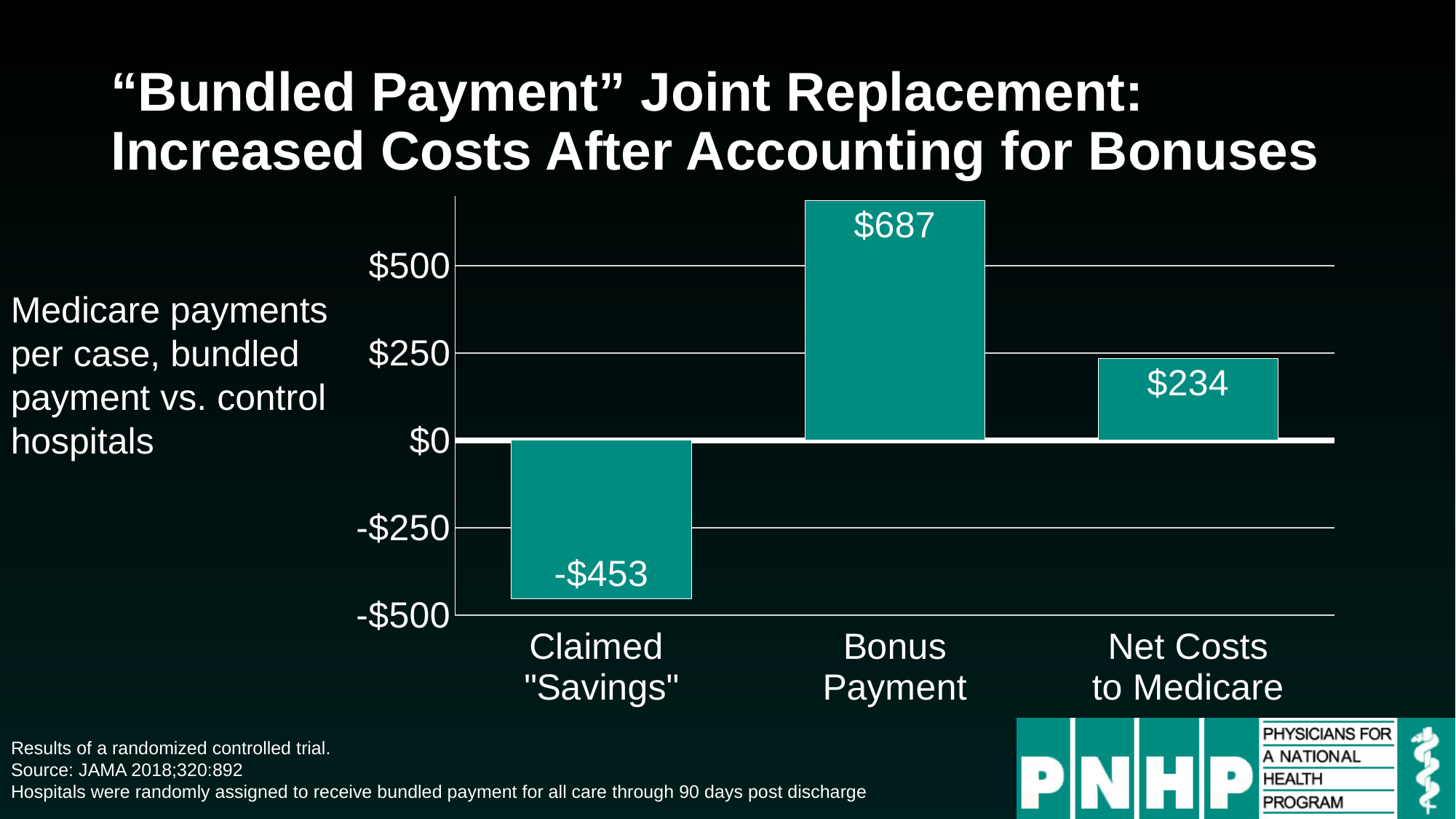
What is the value for Bonus Payment? $687 How many categories are shown on the chart? 3 Is the value for Net Costs to Medicare greater or less than $250? less Which category has the highest value? Bonus Payment Which is larger, the value for Bonus Payment or the value for Net Costs to Medicare? Bonus Payment Which category has a negative value? Claimed "Savings" What is the difference between the Bonus Payment value and the Net Costs to Medicare value? $453 Is the value for Bonus Payment greater or less than $500? greater What is the value for Claimed "Savings"? -$453 What is the value for Net Costs to Medicare? $234 Which category has the lowest value? Claimed "Savings" What kind of chart is shown on the slide? Bar chart